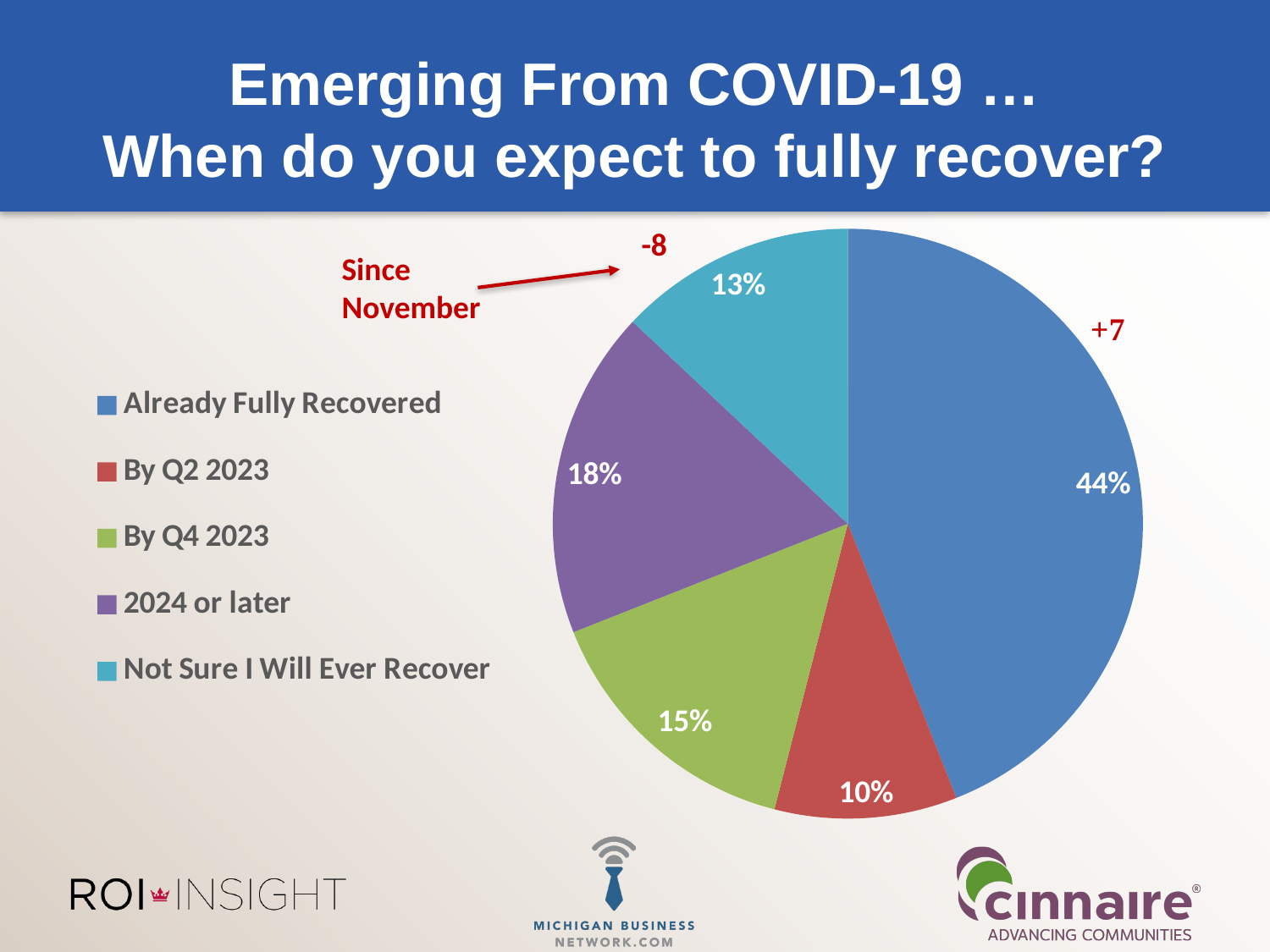
Which category has the smallest share of the pie? By Q2 2023 What percentage of respondents expect to recover By Q4 2023? 15% How many categories does the pie chart show? 5 What is the difference in percentage points between Already Fully Recovered and 2024 or later? 26 What kind of chart is shown on the slide? Pie chart Which is larger, the share for By Q4 2023 or the share for Not Sure I Will Ever Recover? By Q4 2023 What percentage of respondents expect to recover By Q2 2023? 10% What percentage of respondents said they have Already Fully Recovered? 44% What percentage of respondents expect to recover in 2024 or later? 18% What change since November is annotated next to the Already Fully Recovered slice? +7 What percentage of respondents are Not Sure I Will Ever Recover? 13% Which category has the largest share of the pie? Already Fully Recovered